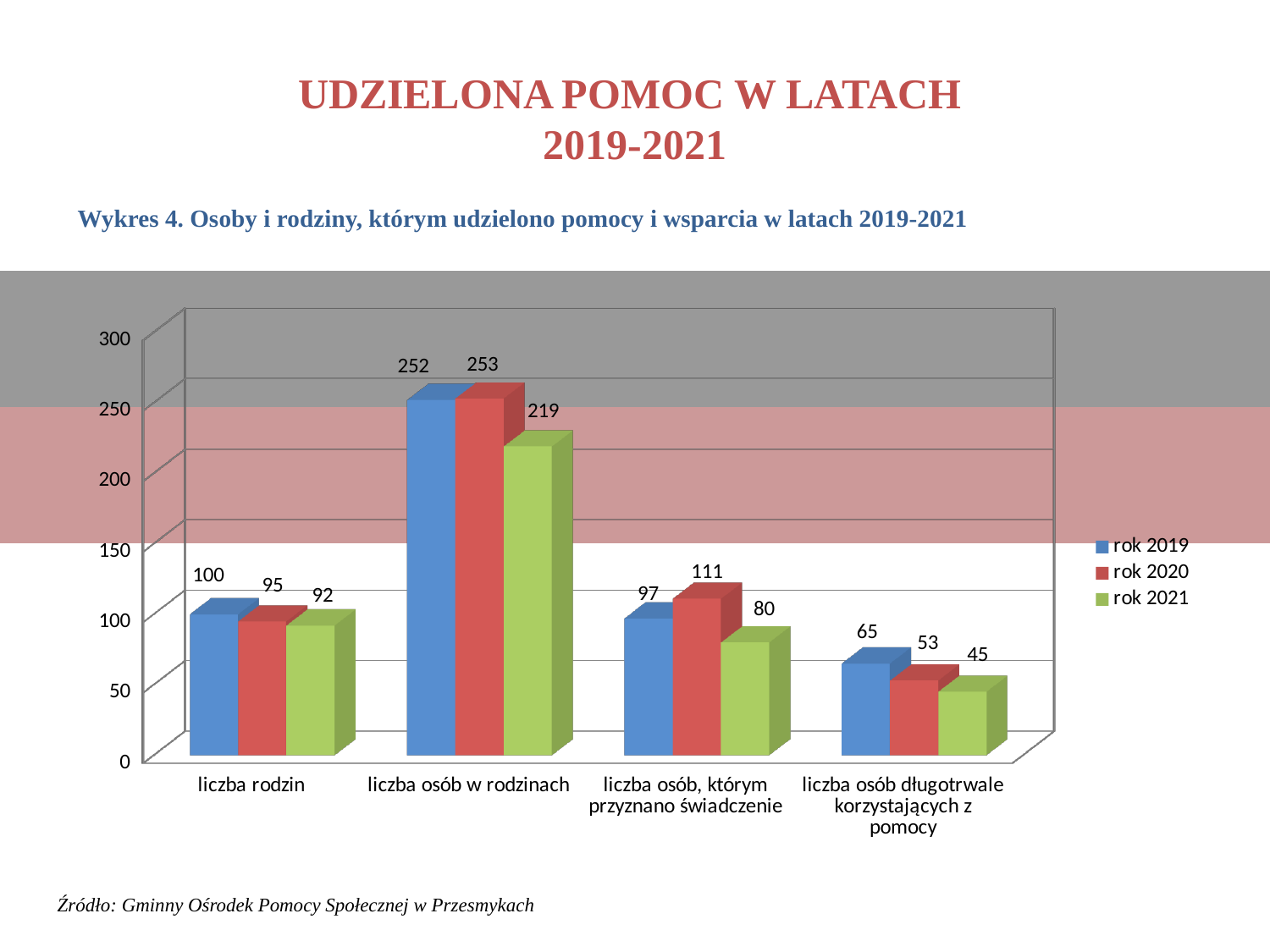
What is the value for "liczba osób długotrwale korzystających z pomocy" in the "rok 2021" series? 45 How many categories are shown on the x axis? 4 What kind of chart is shown on the slide? bar chart What is the value for "liczba osób, którym przyznano świadczenie" in the "rok 2020" series? 111 How many series does the legend list? 3 Which category has the highest value in the "rok 2020" series? liczba osób w rodzinach What is the value for "liczba osób w rodzinach" in the "rok 2021" series? 219 What is the value for "liczba rodzin" in the "rok 2019" series? 100 For "liczba osób, którym przyznano świadczenie", which is larger: the "rok 2019" value or the "rok 2020" value? rok 2020 What is the difference between the "rok 2019" and "rok 2021" values for "liczba osób w rodzinach"? 33 Which category has the lowest value in the "rok 2019" series? liczba osób długotrwale korzystających z pomocy Which colour represents the "rok 2021" series in the legend? green